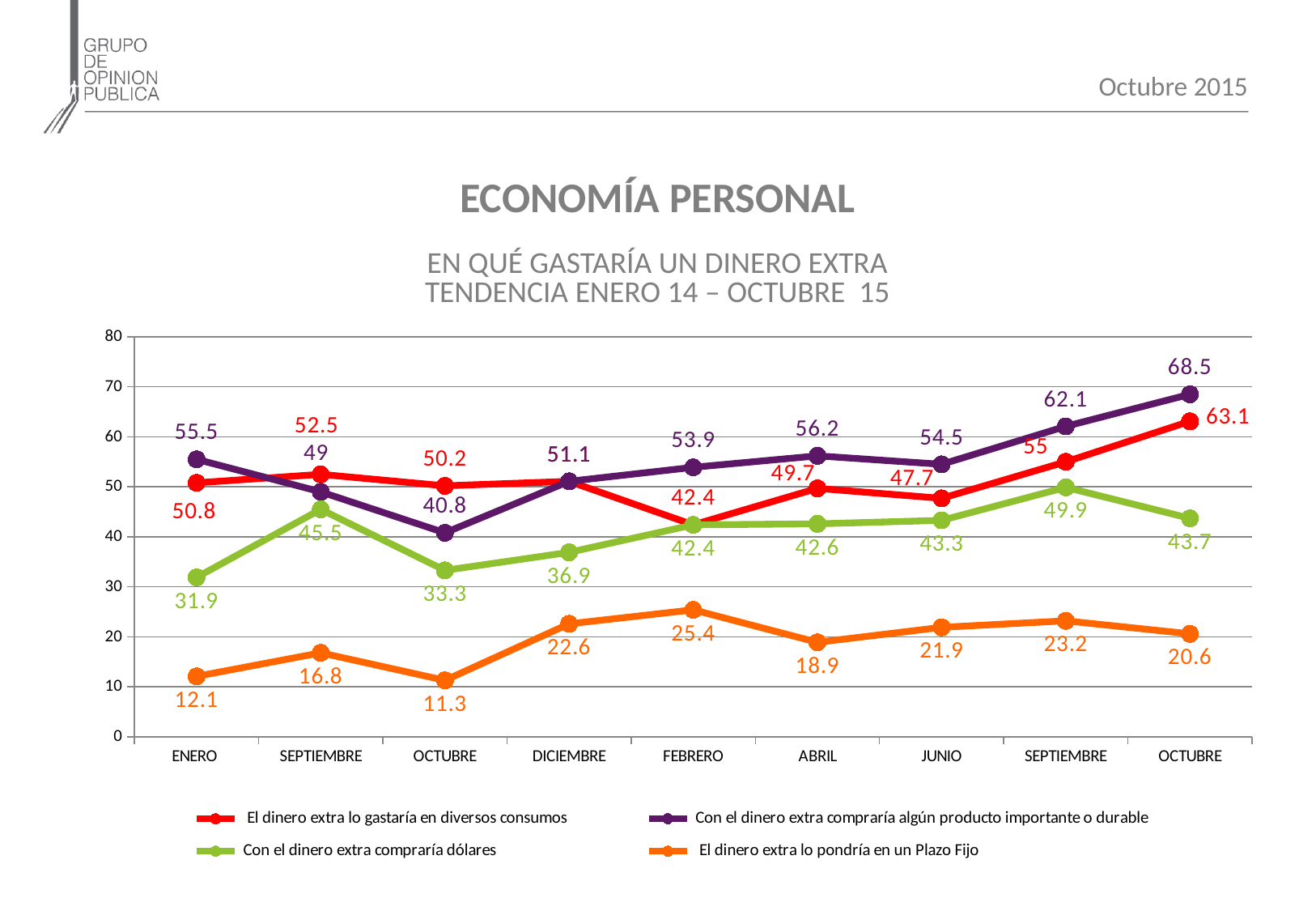
Is the value for 'El dinero extra lo gastaría en diversos consumos' at DICIEMBRE greater or less than 40? greater What is the value for 'El dinero extra lo gastaría en diversos consumos' at JUNIO? 47.7 What colour is the line for 'El dinero extra lo pondría en un Plazo Fijo'? orange What is the value for 'El dinero extra lo pondría en un Plazo Fijo' at FEBRERO? 25.4 At ENERO, which is larger: 'El dinero extra lo gastaría en diversos consumos' or 'Con el dinero extra compraría algún producto importante o durable'? Con el dinero extra compraría algún producto importante o durable What is the value for 'Con el dinero extra compraría dólares' at DICIEMBRE? 36.9 How many series does the legend list? 4 What is the highest value reached by 'Con el dinero extra compraría algún producto importante o durable'? 68.5 How many points are there along the x axis? 9 What kind of chart is shown on the slide? line chart What is the lowest value for 'El dinero extra lo pondría en un Plazo Fijo'? 11.3 At the last OCTUBRE point, what is the difference between 'Con el dinero extra compraría algún producto importante o durable' and 'El dinero extra lo gastaría en diversos consumos'? 5.4